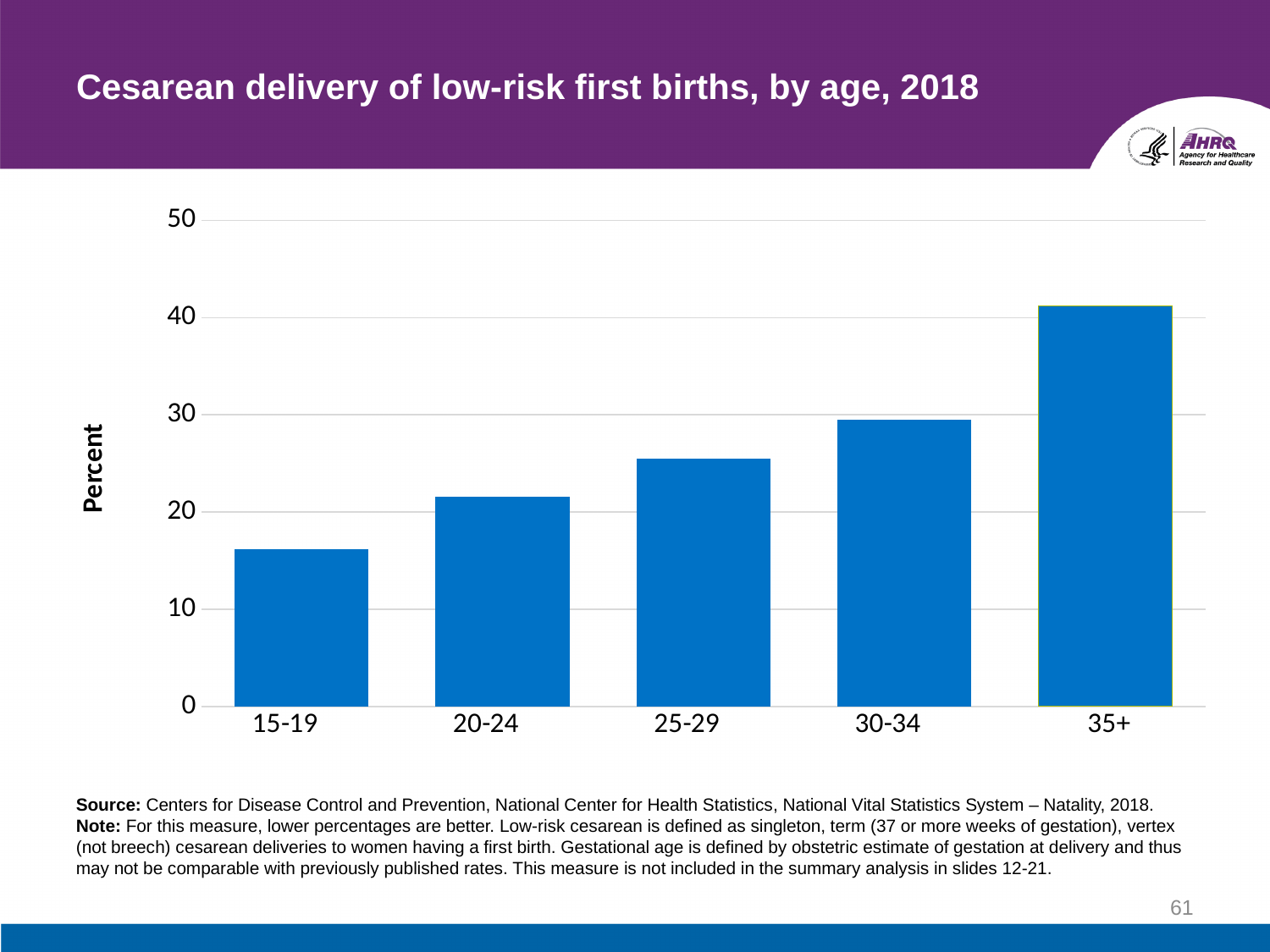
Is the value for the 35+ age group greater or less than 30? greater Is the value for the 15-19 age group greater or less than 20? less Is the value for the 25-29 age group greater or less than 30? less Which age group has the highest percentage of cesarean deliveries? 35+ Which is larger, the value for 25-29 or the value for 30-34? 30-34 Which age group has the lowest percentage of cesarean deliveries? 15-19 How many age groups are shown on the x axis? 5 Do the values rise or fall as age increases along the x axis? rise What kind of chart is shown on the slide? bar chart What is the label on the y axis? Percent